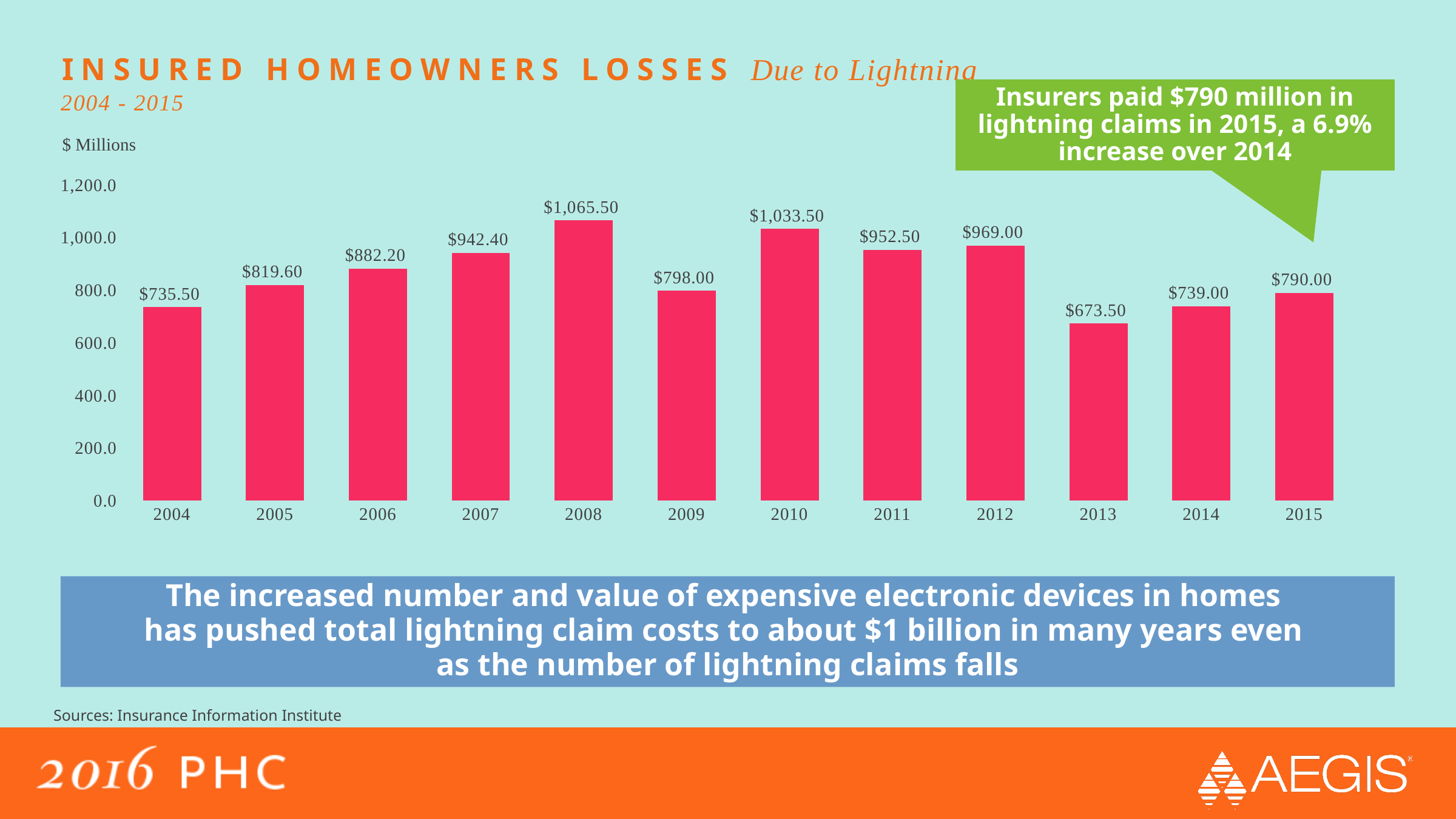
Which year had the lowest insured homeowners losses due to lightning? 2013 What was the insured homeowners loss due to lightning in 2013? $673.50 What is the difference between the 2015 and 2014 values? $51.00 Which year had a larger value, 2011 or 2012? 2012 What kind of chart is shown on the slide? bar chart How many years are shown on the chart? 12 Which year had the highest insured homeowners losses due to lightning? 2008 Is the value for 2010 greater or less than 1,000.0? greater What was the insured homeowners loss due to lightning in 2015? $790.00 What was the insured homeowners loss due to lightning in 2008? $1,065.50 What is the difference between the 2008 and 2009 values? $267.50 What unit is shown on the y axis of the chart? $ Millions